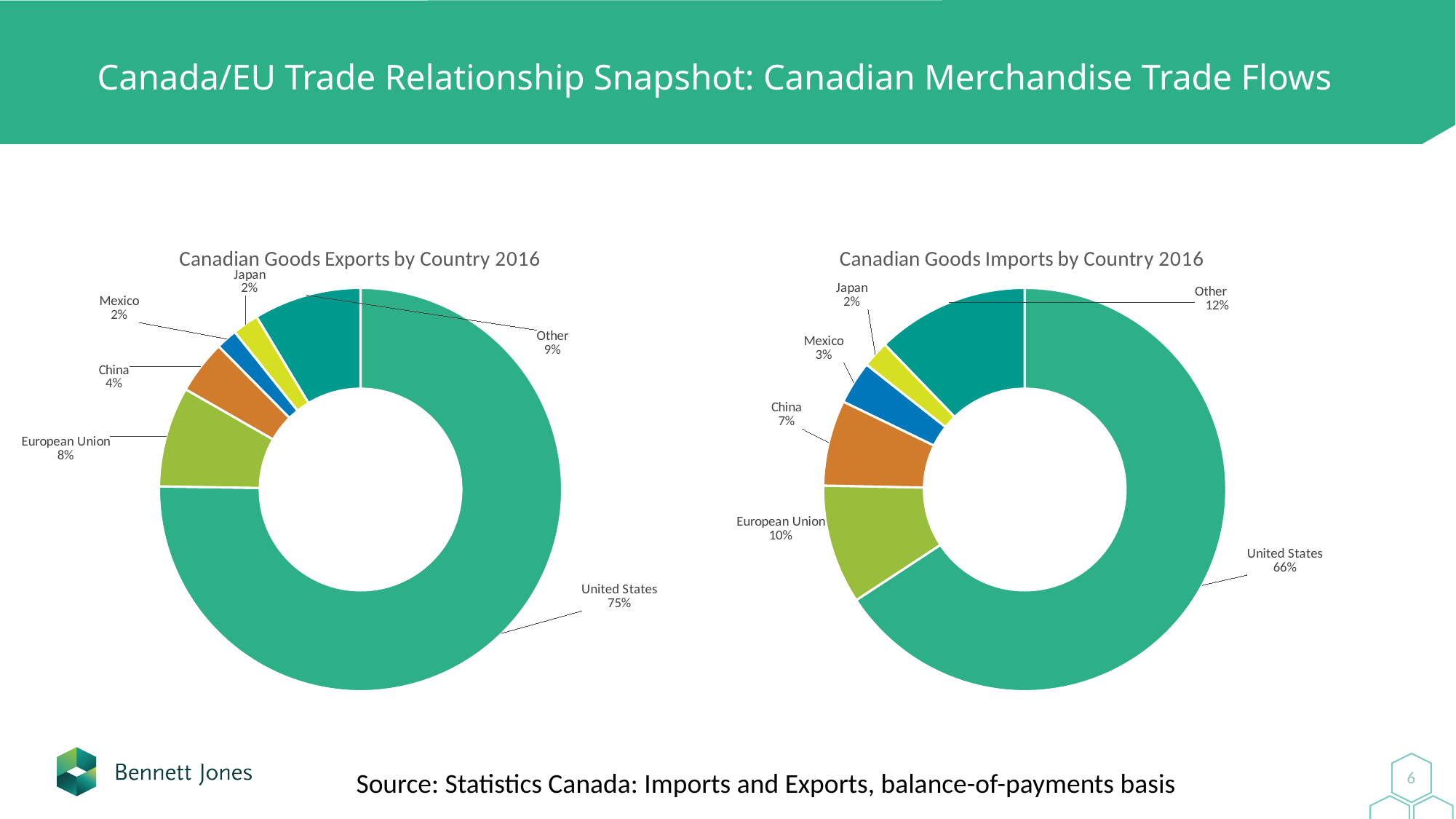
In the 'Canadian Goods Imports by Country 2016' chart, what share of imports comes from the European Union? 10% What is the title of the chart on the left side of the slide? Canadian Goods Exports by Country 2016 What is the difference between the United States share in the exports chart and the United States share in the imports chart? 9% In the 'Canadian Goods Imports by Country 2016' chart, what is the difference between the China share and the Mexico share? 4% In the 'Canadian Goods Imports by Country 2016' chart, what is the share for Other? 12% What kind of chart is 'Canadian Goods Imports by Country 2016'? Doughnut (pie) chart Is the European Union share larger in the exports chart or the imports chart? Imports chart In the 'Canadian Goods Exports by Country 2016' chart, which category has the smallest share, Mexico or the European Union? Mexico In the 'Canadian Goods Exports by Country 2016' chart, what is the share for China? 4% In the 'Canadian Goods Exports by Country 2016' chart, what share of exports goes to the United States? 75% How many categories are shown in the 'Canadian Goods Exports by Country 2016' chart? 6 In the 'Canadian Goods Imports by Country 2016' chart, which country has the largest share? United States